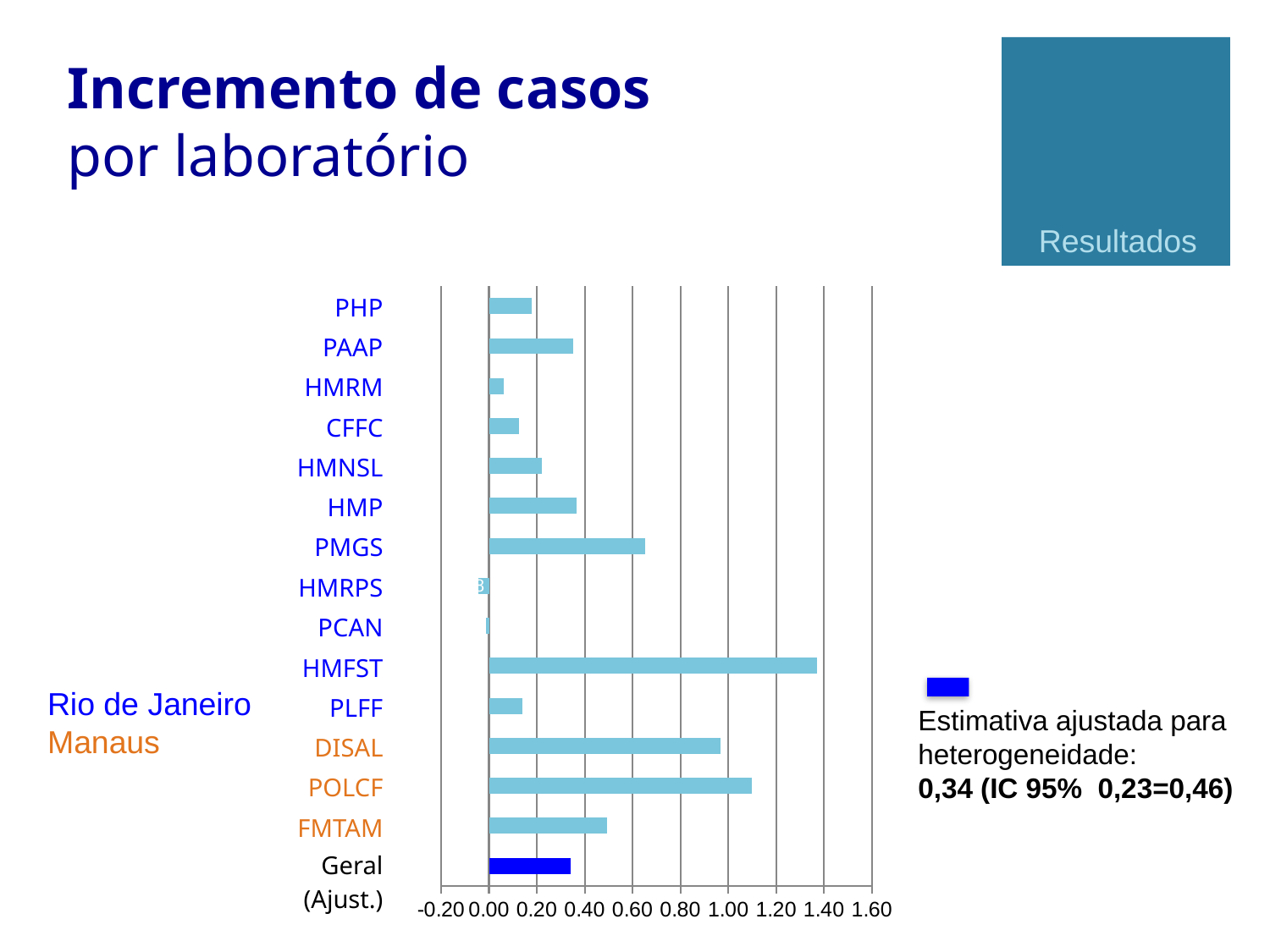
Is the value for POLCF greater or less than 1.00? greater What is the adjusted overall estimate (Geral Ajust.) shown on the slide? 0,34 Which category's bar is drawn in dark blue rather than light blue? Geral (Ajust.) Which has the larger value, POLCF or DISAL? POLCF Which laboratory has the highest value on the chart? HMFST Is the value for DISAL greater or less than 0.80? greater How many laboratory categories are plotted on the chart? 15 Is the value for HMRPS greater or less than 0.00? less What kind of chart is shown on the slide? bar chart Which has the larger value, PMGS or HMP? PMGS